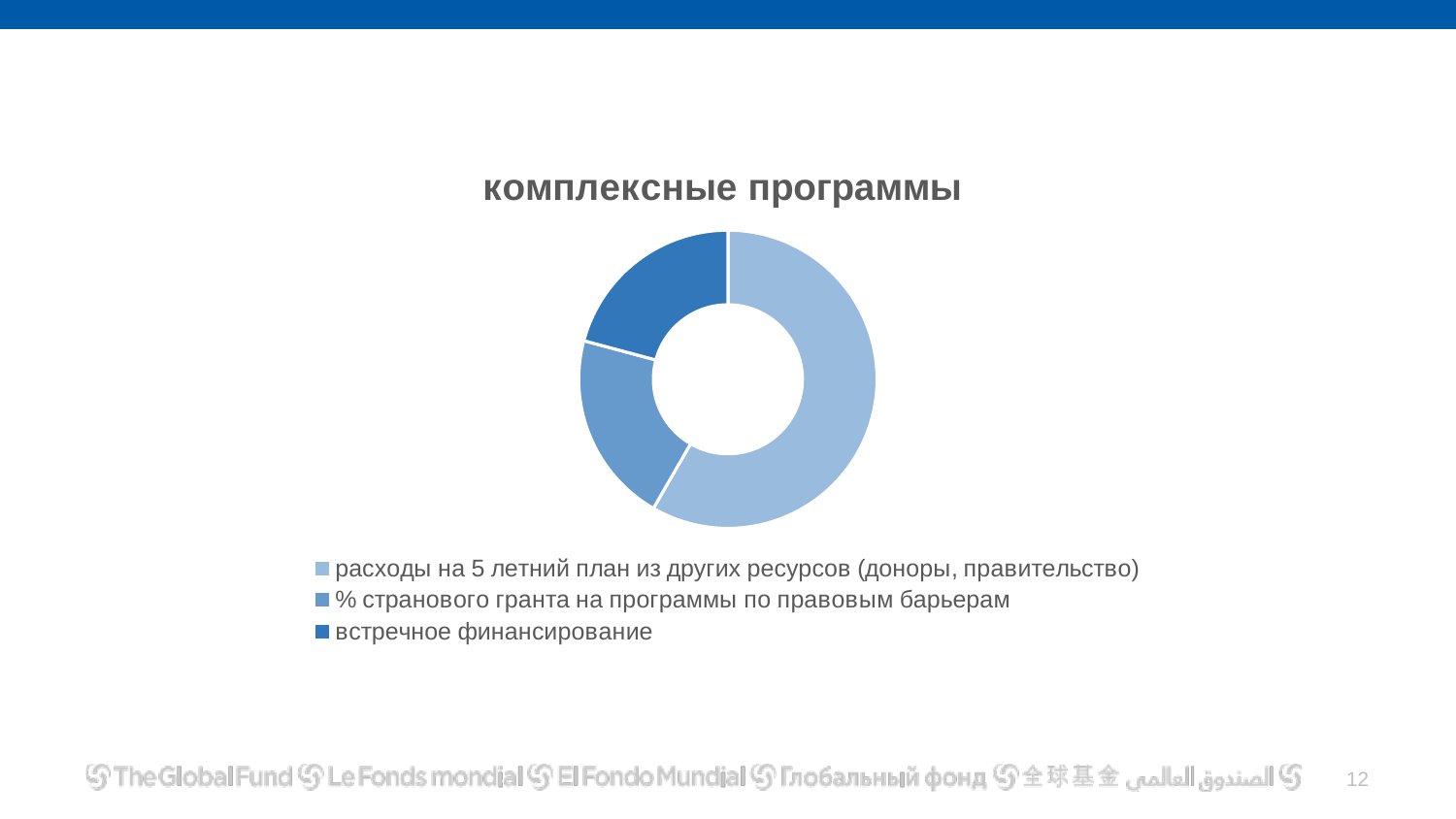
Which legend entry is shown in the darkest blue colour? встречное финансирование What kind of chart is shown on the slide? Doughnut chart Which is larger: the slice for "расходы на 5 летний план из других ресурсов (доноры, правительство)" or the slice for "встречное финансирование"? расходы на 5 летний план из других ресурсов (доноры, правительство) Which legend entry is listed first in the legend below the chart? расходы на 5 летний план из других ресурсов (доноры, правительство) Which category takes up the largest share of the doughnut chart? расходы на 5 летний план из других ресурсов (доноры, правительство) Does the slice for "расходы на 5 летний план из других ресурсов (доноры, правительство)" cover more or less than half of the doughnut? more Which is larger: the slice for "% странового гранта на программы по правовым барьерам" or the slice for "расходы на 5 летний план из других ресурсов (доноры, правительство)"? расходы на 5 летний план из других ресурсов (доноры, правительство) What is the title of the chart? комплексные программы How many categories does the chart's legend list? 3